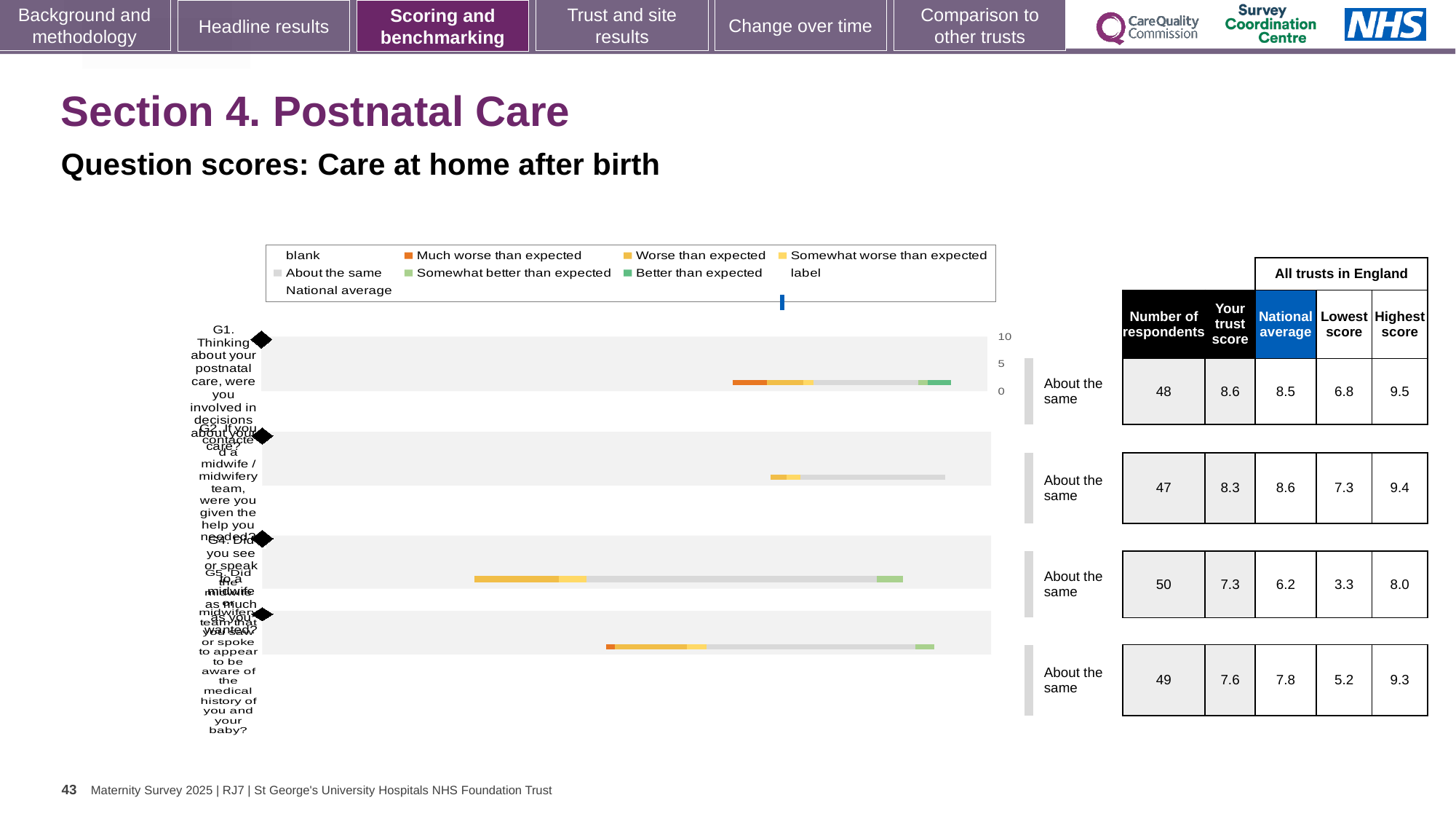
In the table beside the chart, what is 'Your trust score' for the first (top) question, G1? 8.6 In the chart legend, which colour represents 'Much worse than expected'? orange In the table beside the chart, what is the highest score for the fourth (bottom) question row? 9.3 In the table beside the chart, what is the lowest score for the third question row? 3.3 In the chart legend, which colour represents 'Better than expected'? green In the table beside the chart, what is the number of respondents for the first (top) question, G1? 48 In the table beside the chart, what is the difference between the highest score and the lowest score for the third question row? 4.7 How many question bars are plotted in the chart? 4 In the table beside the chart, what is the national average for the second question row? 8.6 Which question row has the highest 'Your trust score' in the table beside the chart? the first (top) row, G1 For the fourth (bottom) question row, which is larger: 'Your trust score' or the national average? national average What type of chart is shown on the slide? bar chart